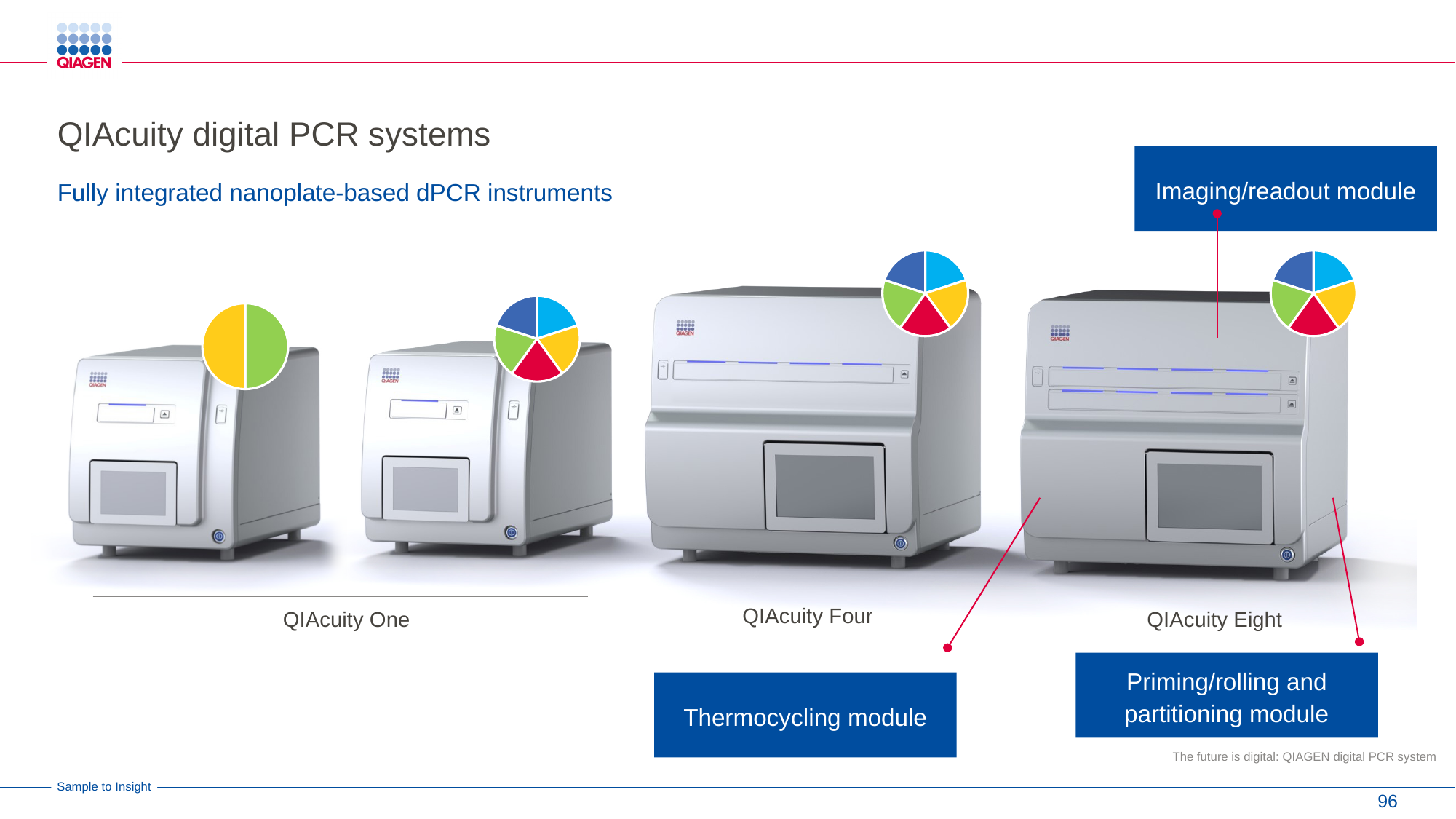
How many slices does the pie above the second instrument from the left have? 5 How many slices does the pie above the QIAcuity Eight instrument have? 5 What two colours make up the pie above the leftmost QIAcuity One instrument? yellow and green What colours appear in the pie above the QIAcuity Eight instrument? blue, light blue, yellow, red and green How many slices does the pie above the leftmost QIAcuity One instrument have? 2 What kind of chart is the icon shown above the leftmost QIAcuity One instrument? pie chart Which instrument's pie has the fewest slices? the leftmost QIAcuity One